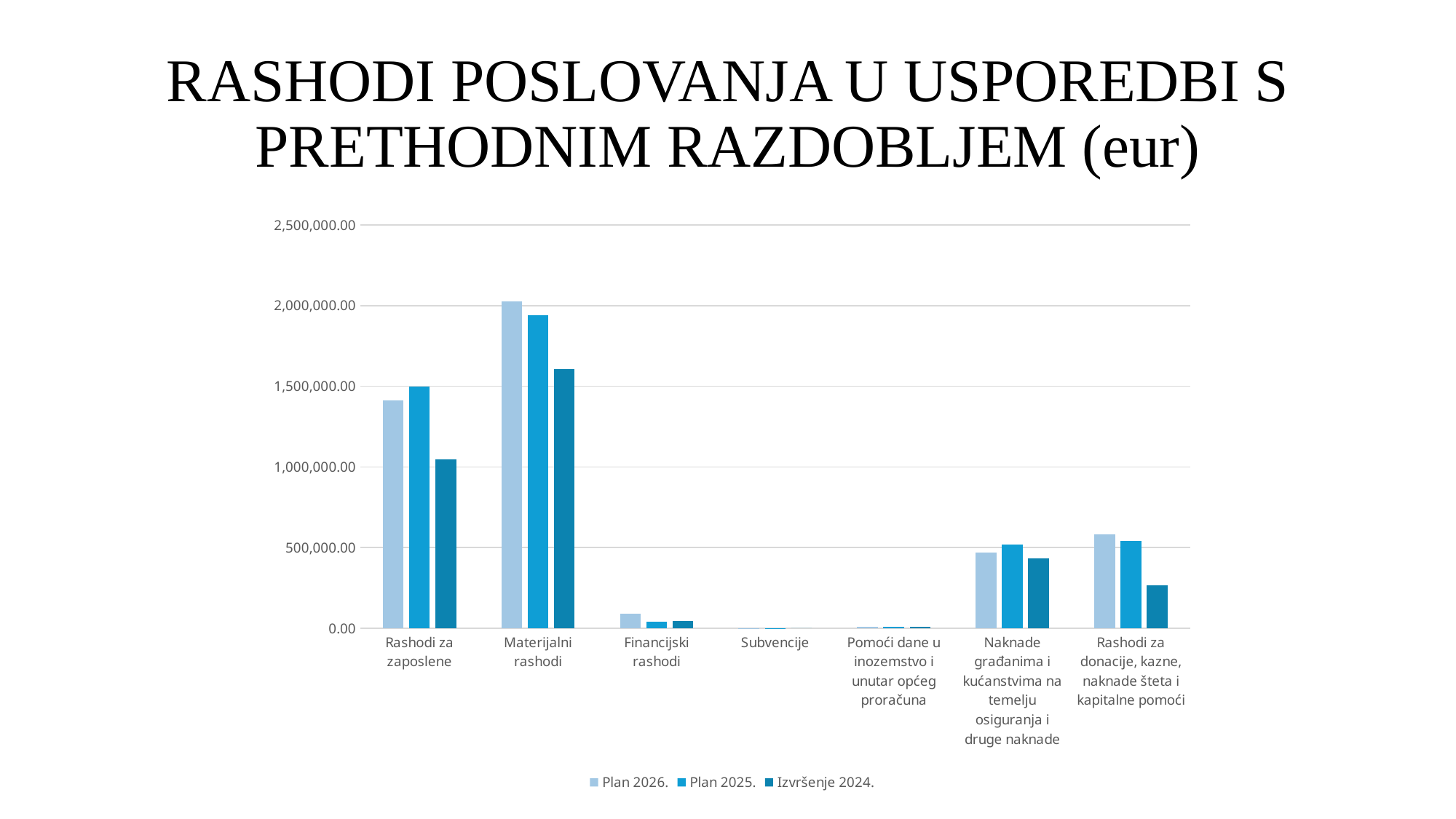
Is the Izvršenje 2024. value for Rashodi za zaposlene greater or less than 1,000,000.00? greater How many series does the legend list? 3 What kind of chart is shown on the slide? bar chart Is the Plan 2026. value for Materijalni rashodi greater or less than 2,000,000.00? greater Is the Izvršenje 2024. value for Rashodi za donacije, kazne, naknade šteta i kapitalne pomoći greater or less than 500,000.00? less Which series has the lowest value for Materijalni rashodi? Izvršenje 2024. What is the title of the slide? RASHODI POSLOVANJA U USPOREDBI S PRETHODNIM RAZDOBLJEM (eur) For Rashodi za zaposlene, which is larger: Plan 2025. or Izvršenje 2024.? Plan 2025. What are the three series listed in the legend? Plan 2026., Plan 2025., Izvršenje 2024. How many categories are shown on the x axis? 7 For Rashodi za donacije, kazne, naknade šteta i kapitalne pomoći, which is larger: Plan 2026. or Izvršenje 2024.? Plan 2026. Which category has the highest value for Plan 2026.? Materijalni rashodi